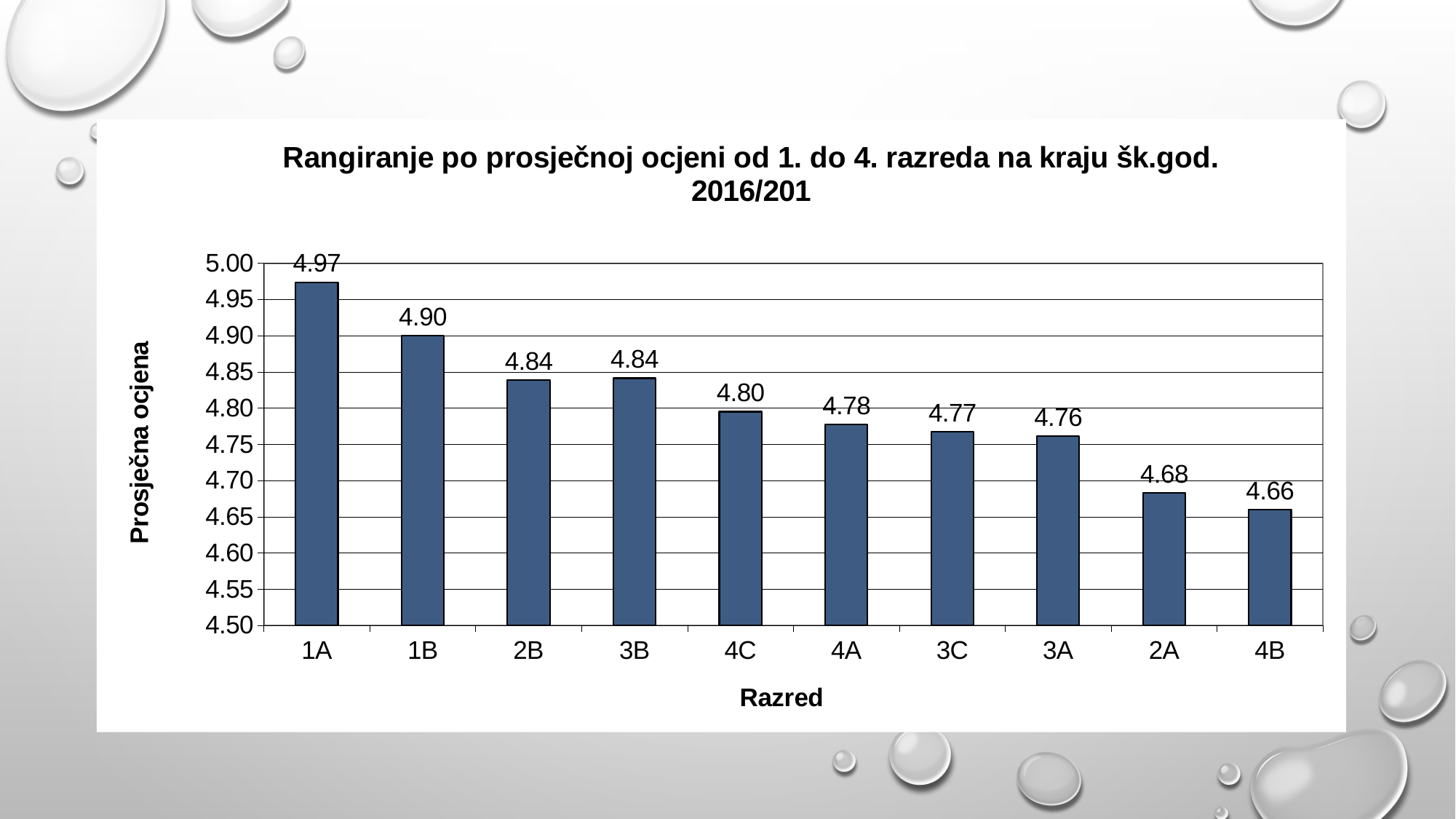
What is the average grade for class 4C? 4.80 Which class has the lowest average grade? 4B What is the difference between the average grades of 1A and 4B? 0.31 Is the value for 3C greater or less than 4.80? less What is the average grade (prosječna ocjena) for class 1A? 4.97 What is the average grade for class 2A? 4.68 What is the difference between the average grades of 1B and 3A? 0.14 Which class has a higher average grade, 4A or 2A? 4A Do the values rise or fall from left to right along the x axis? Fall Which class has the highest average grade? 1A How many classes are shown on the x axis? 10 What kind of chart is shown on the slide? Bar chart